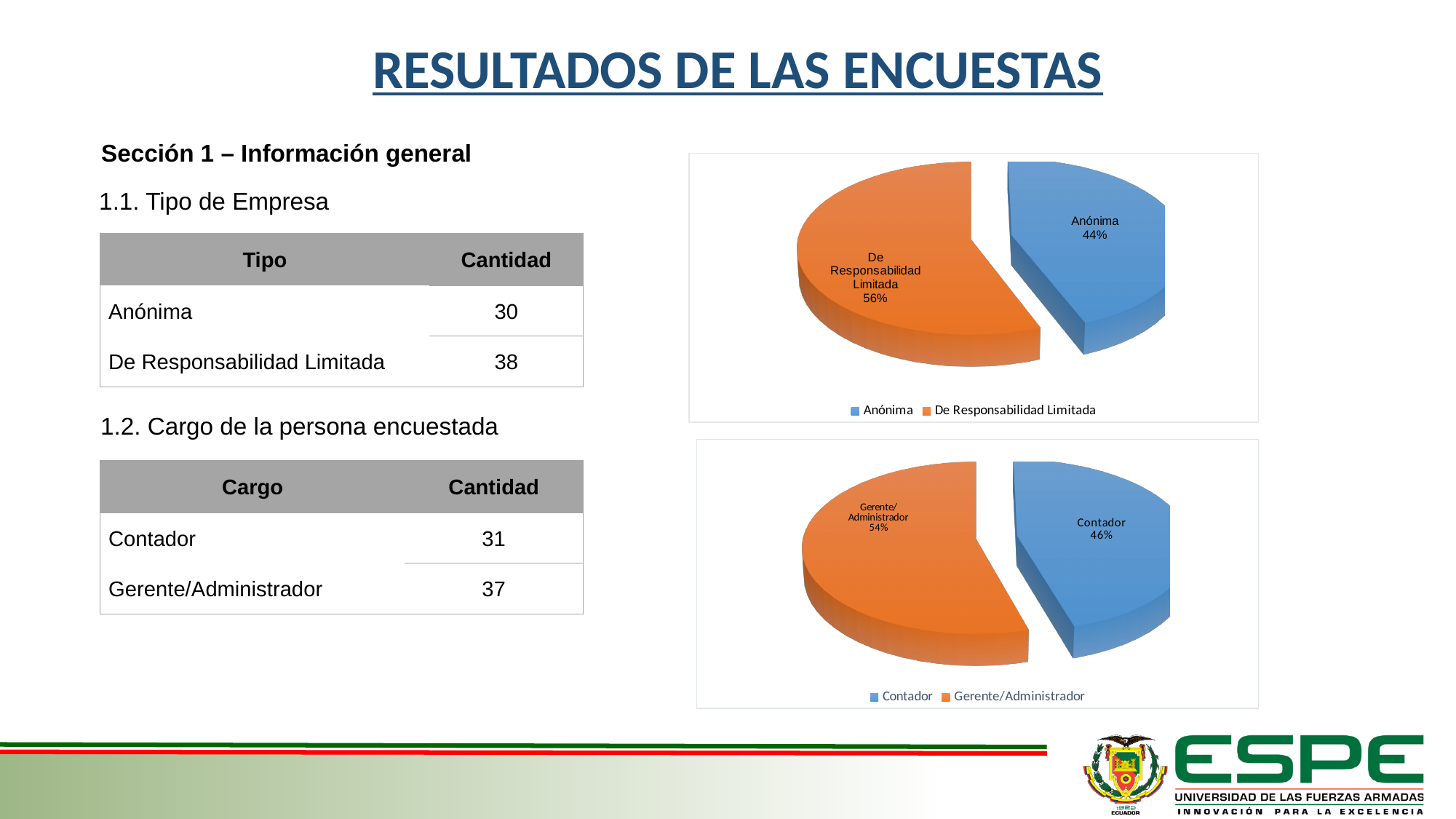
What kind of chart is the top chart on the slide? Pie chart In the bottom pie chart, what share does Contador have? 46% In the bottom pie chart, what share does Gerente/Administrador have? 54% In the bottom pie chart, which is larger, Contador or Gerente/Administrador? Gerente/Administrador In the top pie chart, what share does De Responsabilidad Limitada have? 56% In the bottom pie chart, which category has the smallest slice? Contador How many slices does the top pie chart have? 2 In the top pie chart, what colour is the Anónima slice? Blue In the top pie chart, which category has the largest slice? De Responsabilidad Limitada How many entries does the legend of the bottom pie chart list? 2 In the top pie chart, what is the difference in percentage points between De Responsabilidad Limitada and Anónima? 12 In the top pie chart, what share does Anónima have? 44%